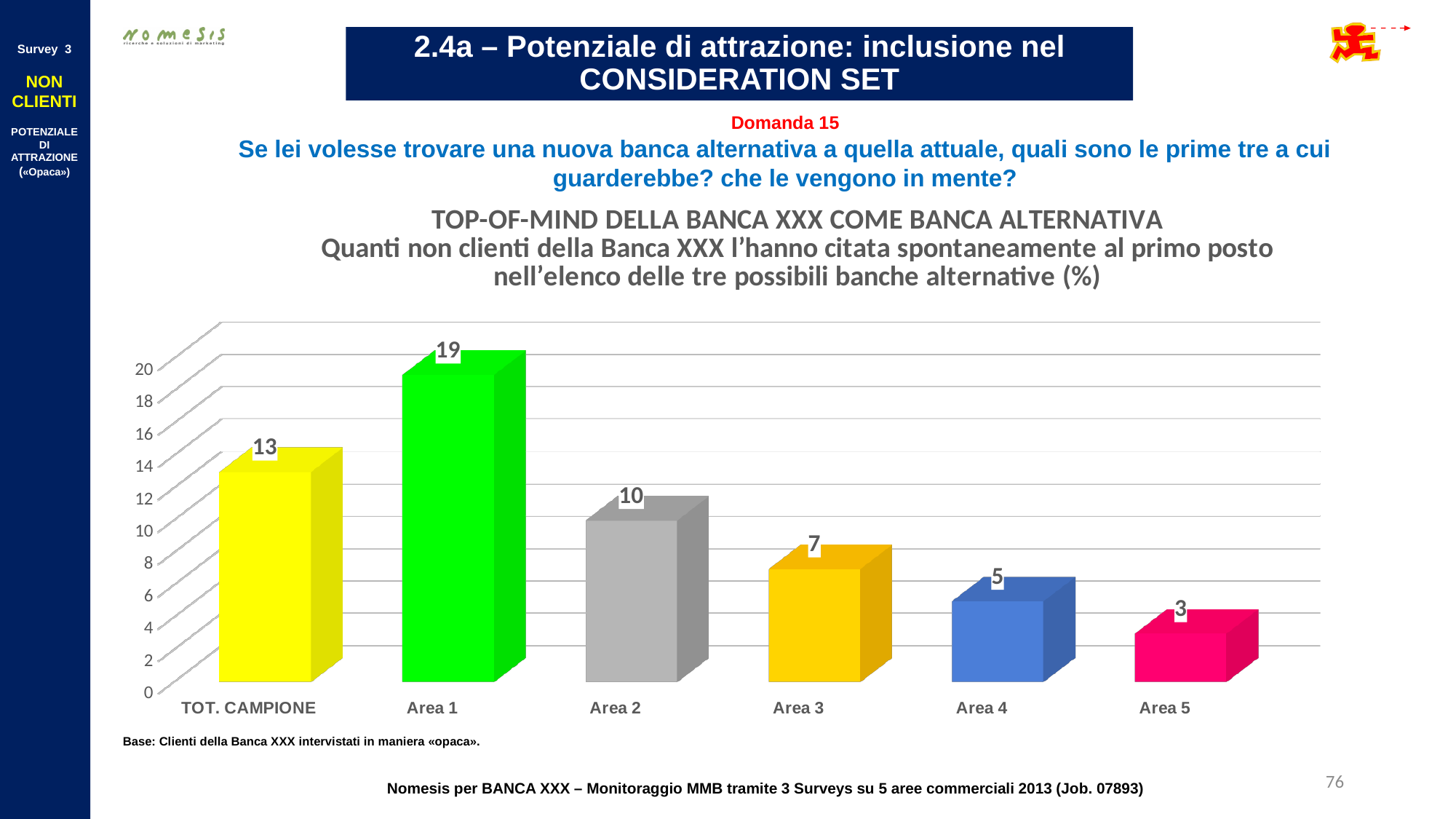
How many categories are shown on the x axis? 6 What is the difference between the values for TOT. CAMPIONE and Area 3? 6 Which is larger, the value for Area 2 or the value for Area 4? Area 2 What is the value for TOT. CAMPIONE? 13 What is the value for Area 1? 19 Is the value for Area 3 greater or less than 10? less Which category has the highest value? Area 1 What is the difference between the values for Area 1 and Area 2? 9 Which category has the lowest value? Area 5 What kind of chart is shown on the slide? bar chart Do the values rise or fall from Area 1 to Area 5? fall What is the value for Area 4? 5